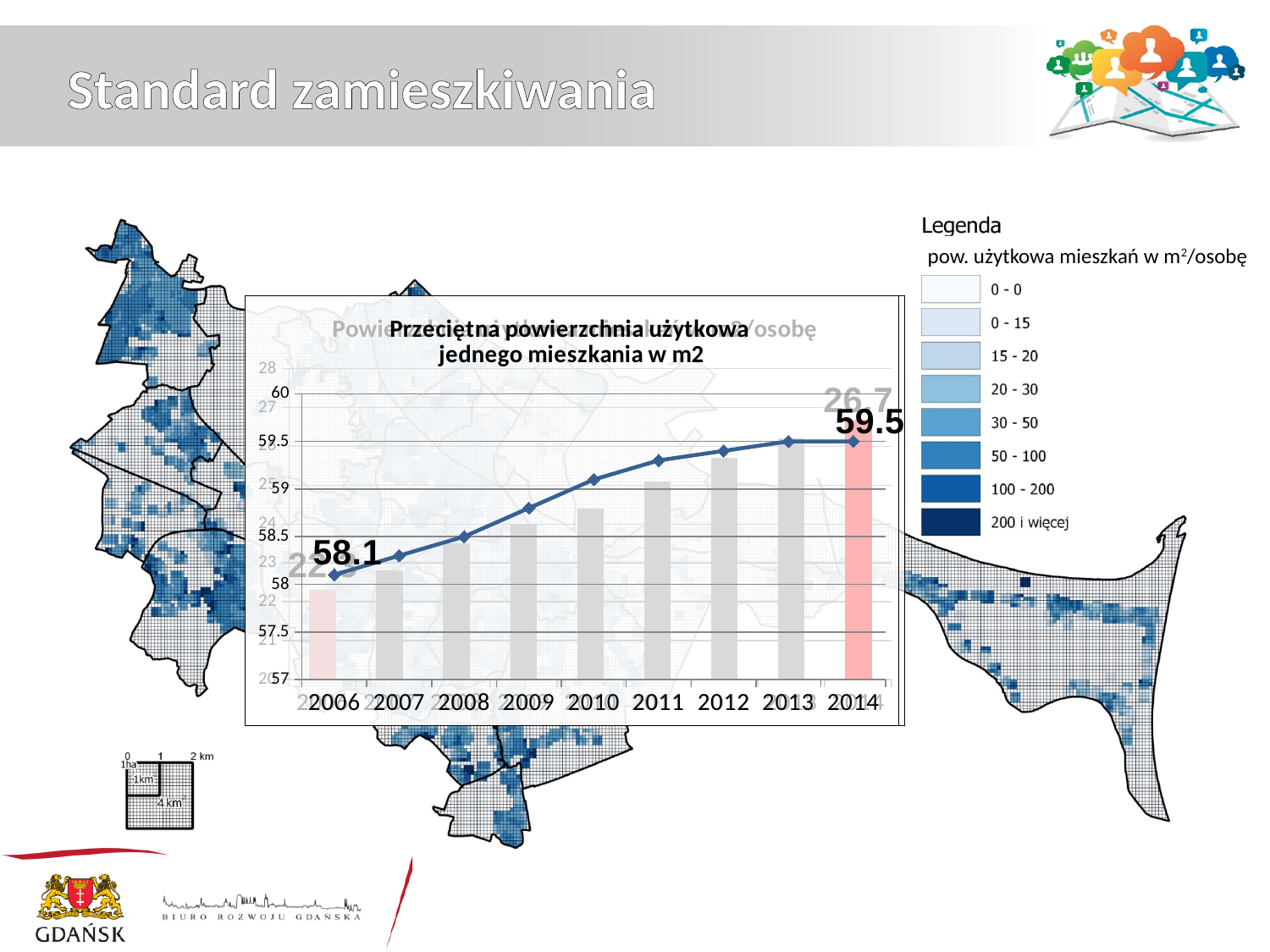
In the chart 'Przeciętna powierzchnia użytkowa jednego mieszkania w m2', what is the value for 2014? 59.5 In the chart 'Przeciętna powierzchnia użytkowa jednego mieszkania w m2', which year has the lowest value? 2006 In the chart 'Przeciętna powierzchnia użytkowa jednego mieszkania w m2', which is larger, the value for 2006 or the value for 2014? 2014 In the chart 'Przeciętna powierzchnia użytkowa jednego mieszkania w m2', do the values rise or fall from 2006 to 2014? rise In the chart 'Przeciętna powierzchnia użytkowa jednego mieszkania w m2', is the value for 2011 greater or less than 58.5? greater What is the title of the line chart on the slide? Przeciętna powierzchnia użytkowa jednego mieszkania w m2 How many years are shown on the x axis of the chart 'Przeciętna powierzchnia użytkowa jednego mieszkania w m2'? 9 In the chart 'Przeciętna powierzchnia użytkowa jednego mieszkania w m2', what is the difference between the 2014 and 2006 values? 1.4 In the chart 'Przeciętna powierzchnia użytkowa jednego mieszkania w m2', is the value for 2012 greater or less than 59? greater In the chart 'Przeciętna powierzchnia użytkowa jednego mieszkania w m2', is the value for 2008 greater or less than 59? less In the chart 'Przeciętna powierzchnia użytkowa jednego mieszkania w m2', which year has the highest value? 2013 and 2014 In the chart 'Przeciętna powierzchnia użytkowa jednego mieszkania w m2', what is the value for 2006? 58.1